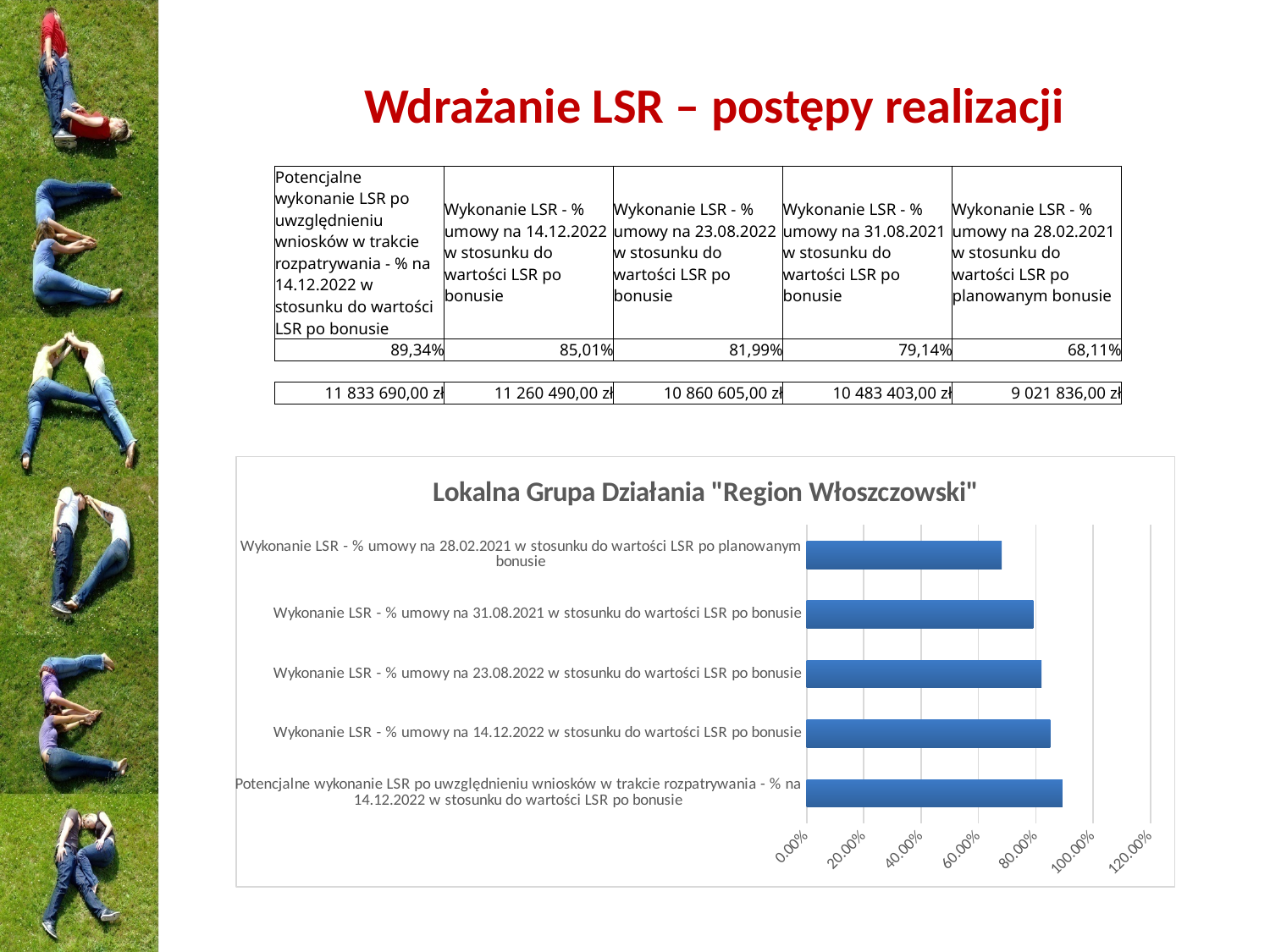
According to the table on the slide, what value does the bar for 'Wykonanie LSR - % umowy na 31.08.2021 w stosunku do wartości LSR po bonusie' represent? 79,14% How many bars (categories) does the chart show? 5 Is the bar for 'Wykonanie LSR - % umowy na 28.02.2021 w stosunku do wartości LSR po planowanym bonusie' greater or less than 80.00%? less Which category has the shortest bar in the chart? Wykonanie LSR - % umowy na 28.02.2021 w stosunku do wartości LSR po planowanym bonusie Is the bar for 'Wykonanie LSR - % umowy na 14.12.2022 w stosunku do wartości LSR po bonusie' greater or less than 80.00%? greater Is the bar for 'Potencjalne wykonanie LSR po uwzględnieniu wniosków w trakcie rozpatrywania' greater or less than 100.00%? less Which bar is longer: 'Wykonanie LSR - % umowy na 14.12.2022' or 'Wykonanie LSR - % umowy na 28.02.2021'? Wykonanie LSR - % umowy na 14.12.2022 Which category has the longest bar in the chart? Potencjalne wykonanie LSR po uwzględnieniu wniosków w trakcie rozpatrywania - % na 14.12.2022 w stosunku do wartości LSR po bonusie What is the title of the chart? Lokalna Grupa Działania "Region Włoszczowski" What kind of chart is shown on the slide? Bar chart Going from the top bar to the bottom bar, do the bars get longer or shorter? longer What colour are the bars in the chart? Blue